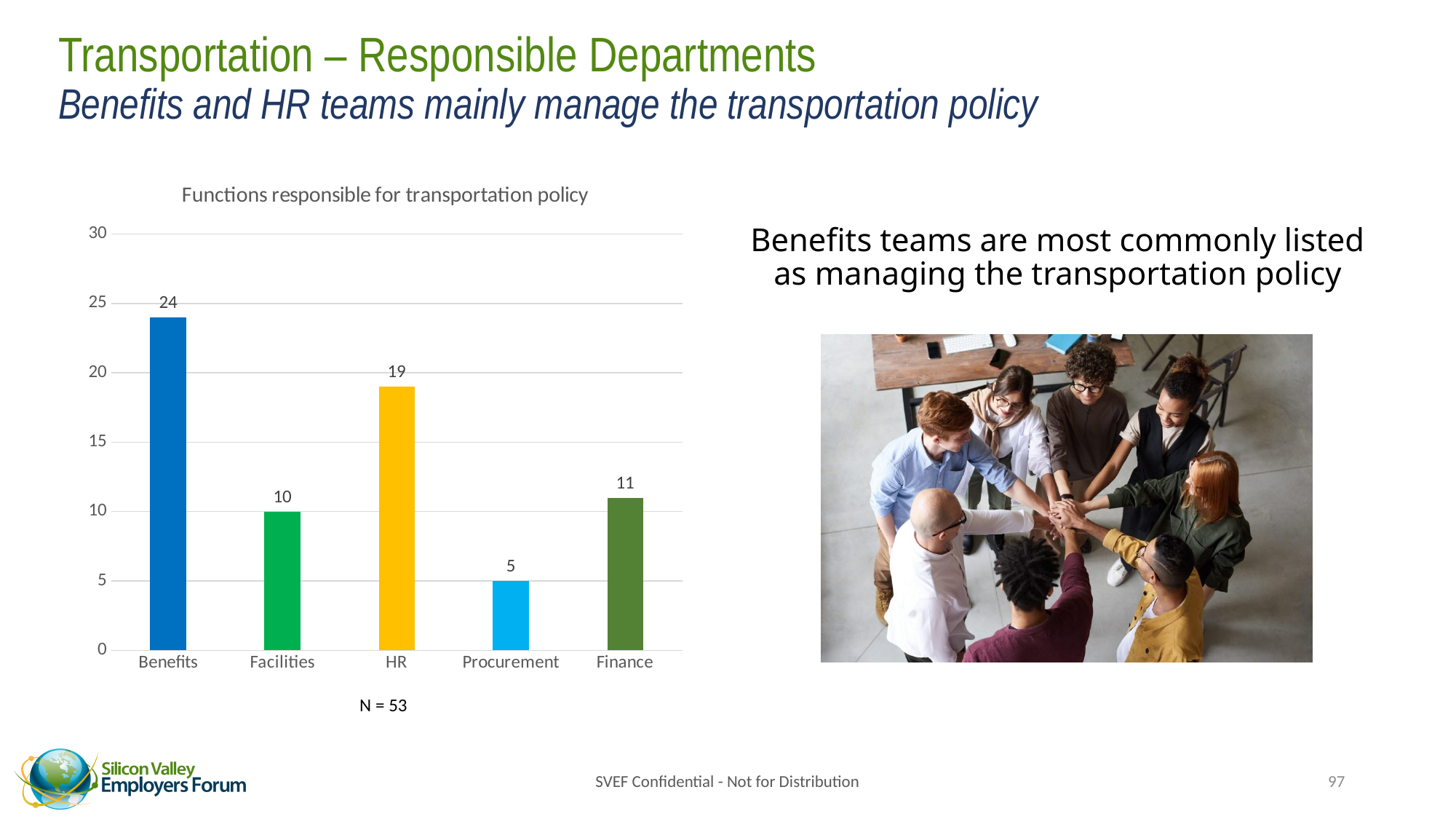
What is the difference between the values for Benefits and HR? 5 What is the value for Finance? 11 What kind of chart is shown? bar chart Which is larger, the value for Facilities or the value for Finance? Finance What is the value for Benefits? 24 How many functions are shown on the chart? 5 Which function has the lowest value? Procurement What is the value for Procurement? 5 What is the title of the chart? Functions responsible for transportation policy Is the value for Facilities greater or less than 15? less Which function has the highest value? Benefits What is the value for HR? 19